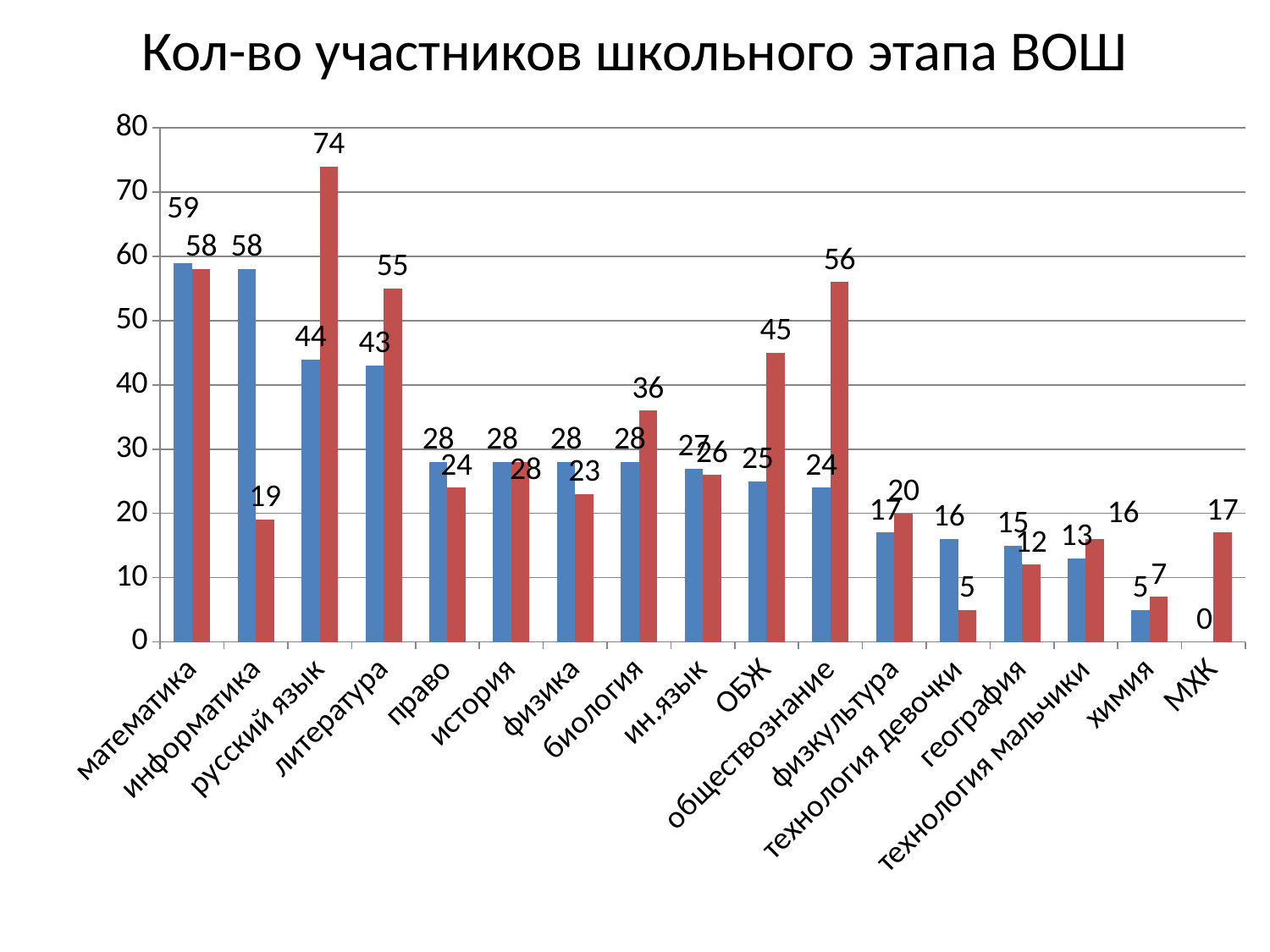
What is the value of the blue bar for технология девочки? 16 What is the difference between the red and blue bars for обществознание? 32 What is the value of the red bar for информатика? 19 Which category has the lowest blue bar? МХК What is the title of the chart? Кол-во участников школьного этапа ВОШ How many categories are shown on the x axis? 17 What is the value of the red bar for русский язык? 74 What is the value of the blue bar for математика? 59 Is the red bar for литература greater or less than 50? greater What type of chart is shown on the slide? bar chart Which category has the highest red bar? русский язык For ОБЖ, which bar is larger, the blue or the red? red